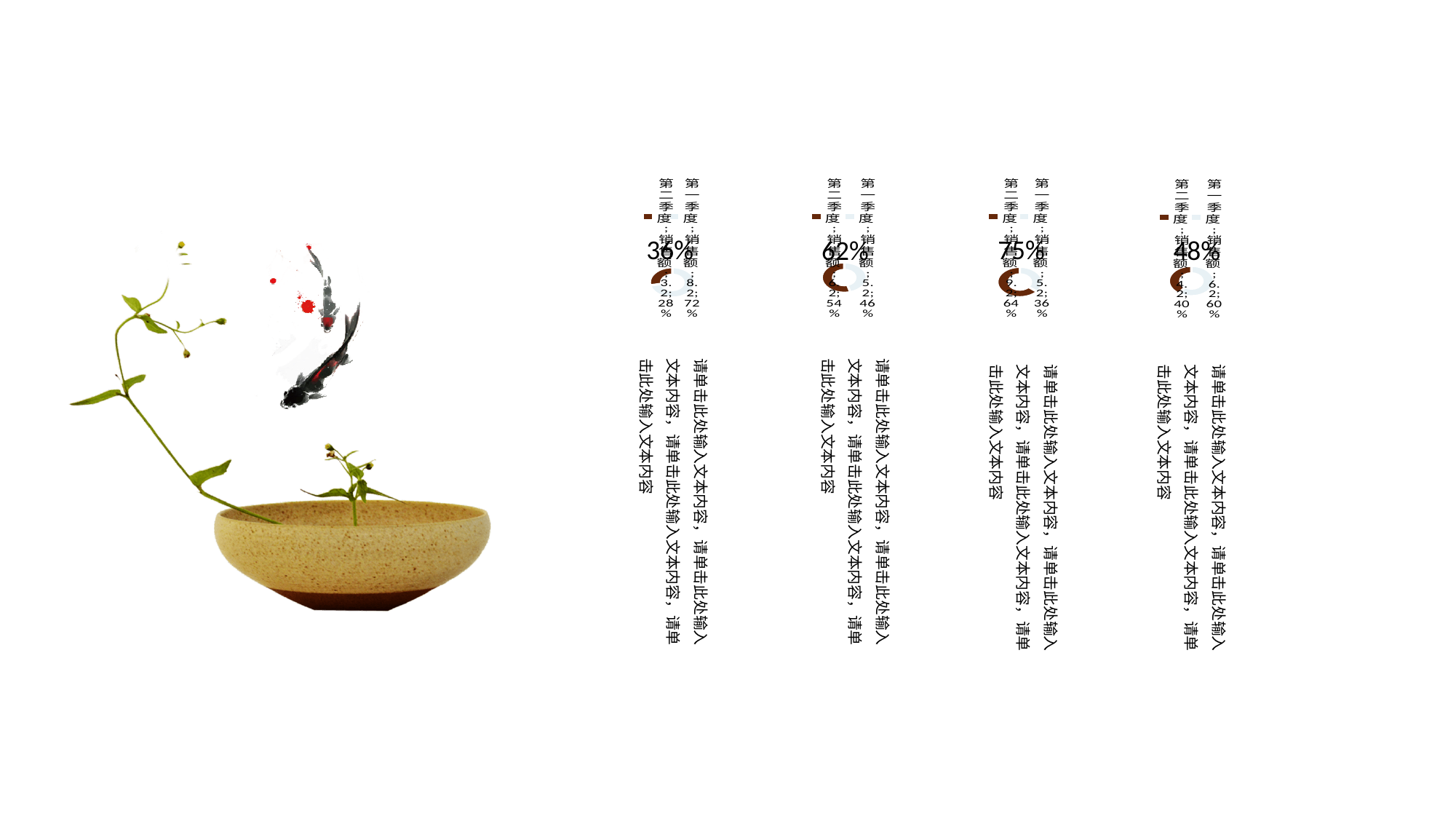
In the second chart from the left, what share does 第一季度 销售额 take? 46% How many slices does each doughnut chart on the slide have? 2 How many doughnut charts are shown on the slide? 4 In the rightmost chart, what share does 第一季度 销售额 take? 60% What kind of chart is the leftmost chart on the slide? doughnut chart In the second chart from the left, what is the value for 第二季度 销售额? 6.2 In the leftmost chart, what share of the doughnut does 第二季度 销售额 take? 28% In the rightmost chart, what is the value for 第二季度 销售额? 4.2 In the leftmost chart, which is larger, 第一季度 销售额 or 第二季度 销售额? 第一季度 销售额 In the third chart from the left, which slice is the largest? 第二季度 销售额